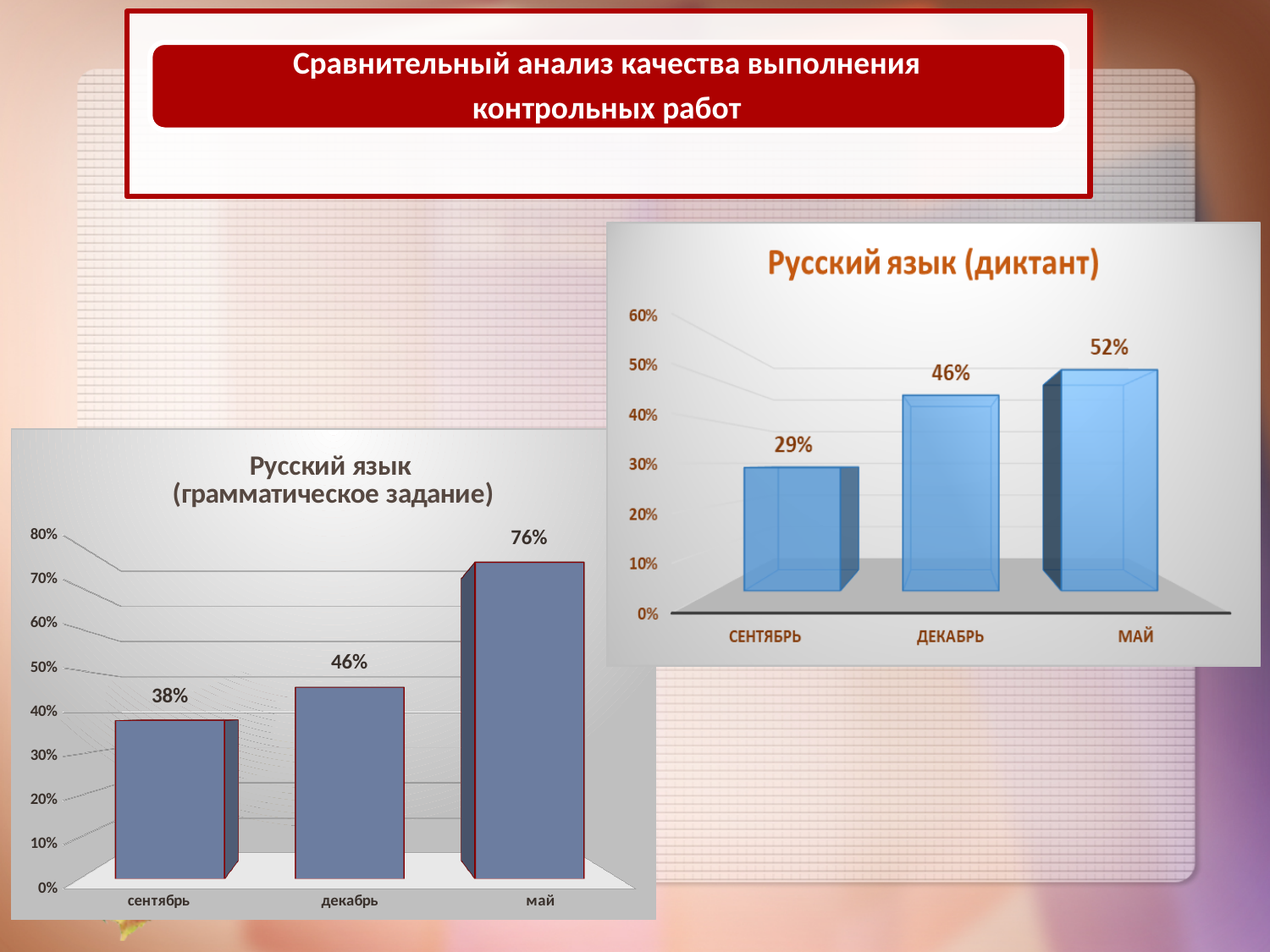
What is the title of the chart on the left side of the slide? Русский язык (грамматическое задание) What kind of chart is 'Русский язык (диктант)'? bar chart In the 'Русский язык (диктант)' chart, what is the value for май? 52% In the 'Русский язык (грамматическое задание)' chart, do the values rise or fall from сентябрь to май? rise In the 'Русский язык (диктант)' chart, which category has the lowest value? сентябрь In the 'Русский язык (грамматическое задание)' chart, which category has the highest value? май In the 'Русский язык (грамматическое задание)' chart, what is the value for декабрь? 46% In the 'Русский язык (диктант)' chart, which is larger, the value for декабрь or the value for май? май How many categories are shown in the 'Русский язык (грамматическое задание)' chart? 3 In the 'Русский язык (диктант)' chart, what is the value for сентябрь? 29% In the 'Русский язык (грамматическое задание)' chart, what is the difference between the values for май and сентябрь? 38% In the 'Русский язык (диктант)' chart, what is the difference between the values for декабрь and сентябрь? 17%